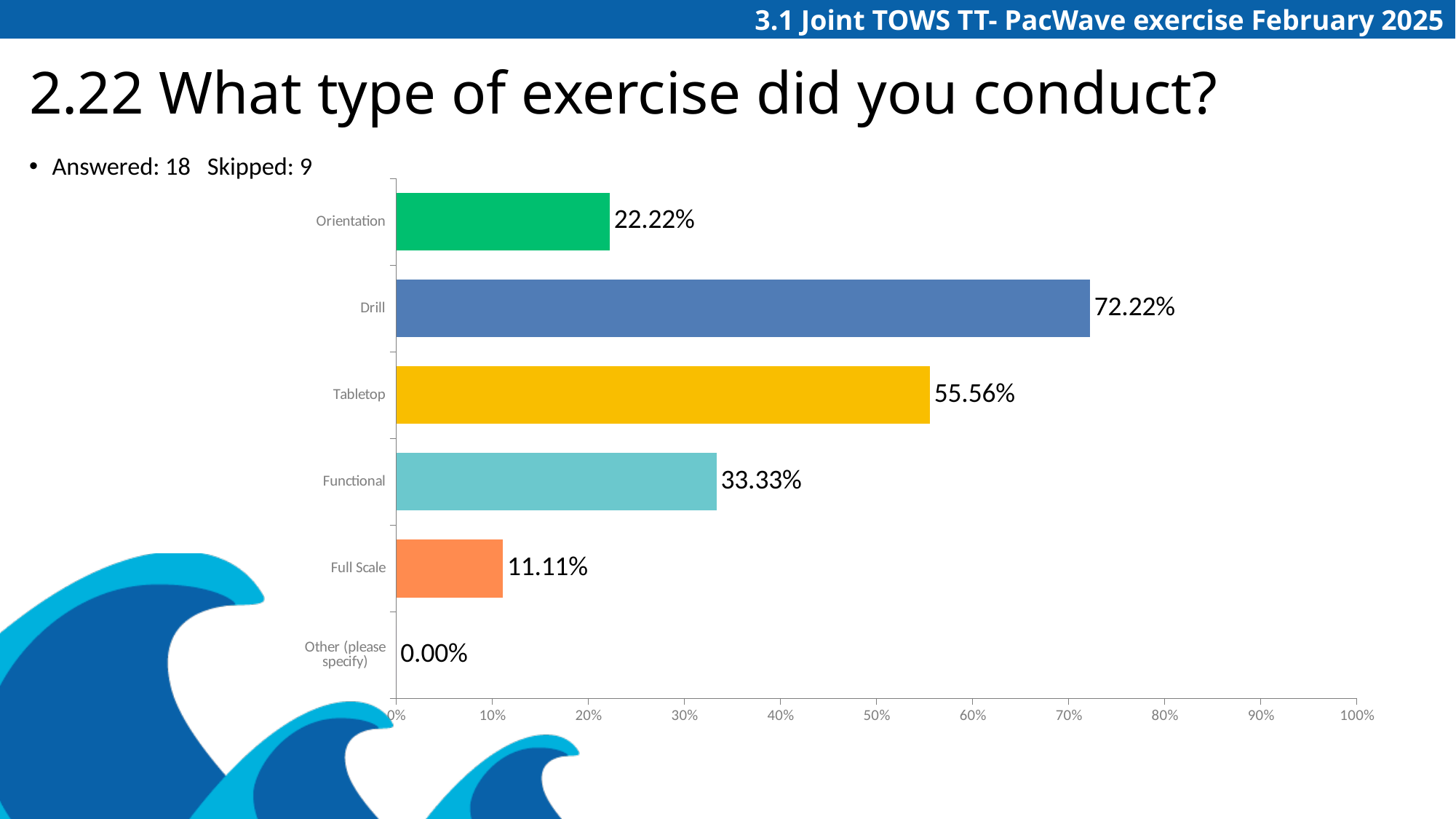
Is the value for Tabletop greater or less than 50%? greater Which is larger, the value for Orientation or the value for Functional? Functional Which exercise type has the highest percentage? Drill What is the value shown for Functional? 33.33% What is the difference between the Drill and Tabletop percentages? 16.66% What percentage of respondents conducted a Drill exercise? 72.22% How many categories are shown on the chart? 6 What colour is the bar for Tabletop? Yellow What is the value shown for Tabletop? 55.56% Which category has the lowest value? Other (please specify) What is the value shown for Full Scale? 11.11% What kind of chart is shown on the slide? Bar chart